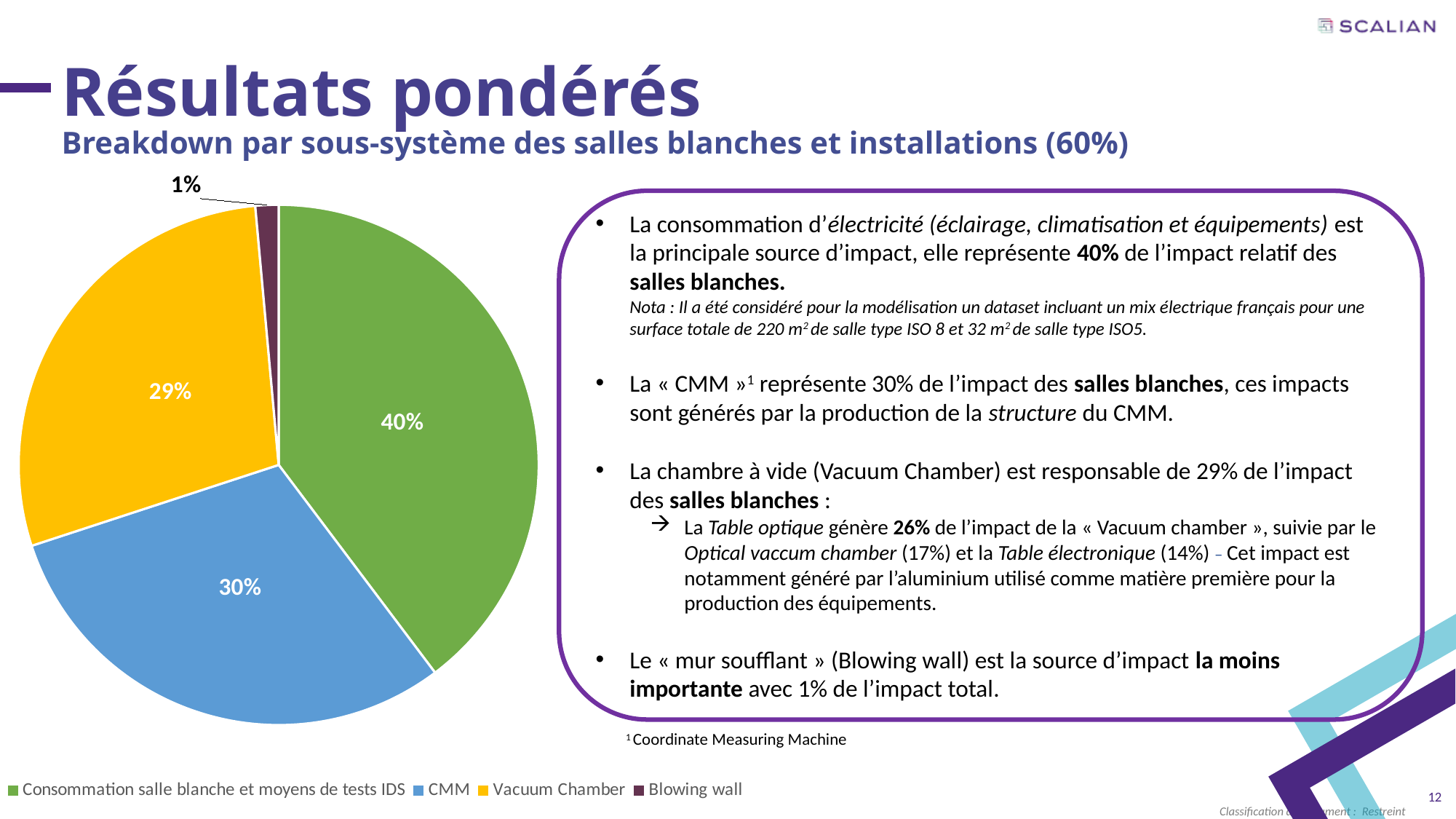
What share of the pie does CMM represent? 30% Which is larger, the slice for CMM or the slice for Blowing wall? CMM What share of the pie does Blowing wall represent? 1% What share of the pie does 'Consommation salle blanche et moyens de tests IDS' represent? 40% How many entries does the legend list? 4 What colour is the Vacuum Chamber slice? yellow Which category has the largest slice of the pie? Consommation salle blanche et moyens de tests IDS What kind of chart is shown on the slide? pie chart Which category has the smallest slice of the pie? Blowing wall How many slices does the pie chart have? 4 What is the difference in percentage points between the CMM slice and the Blowing wall slice? 29 What share of the pie does Vacuum Chamber represent? 29%